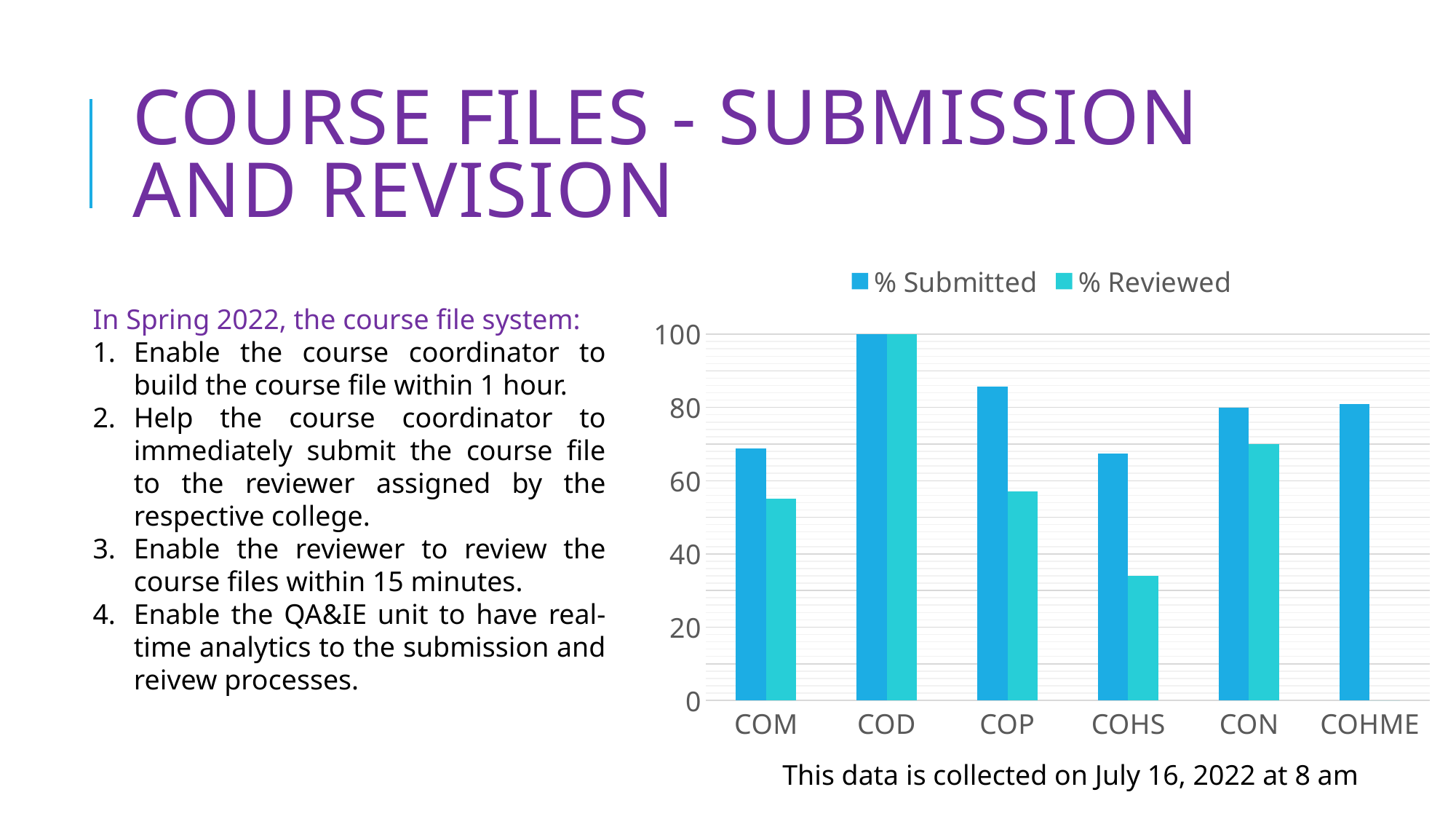
Is the % Reviewed value for CON greater or less than 60? greater Is the % Submitted value for COP greater or less than 80? greater Is the % Submitted value for COM greater or less than 60? greater Which college has the highest % Submitted value? COD What is the % Submitted value for COD? 100 How many colleges are shown on the x axis of the chart? 6 Which is larger, the % Submitted value for COP or the % Submitted value for COHS? COP What are the two series named in the chart legend? % Submitted and % Reviewed Which is larger, the % Reviewed value for COM or the % Reviewed value for COHS? COM What kind of chart is shown on the slide? bar chart How many series does the chart legend list? 2